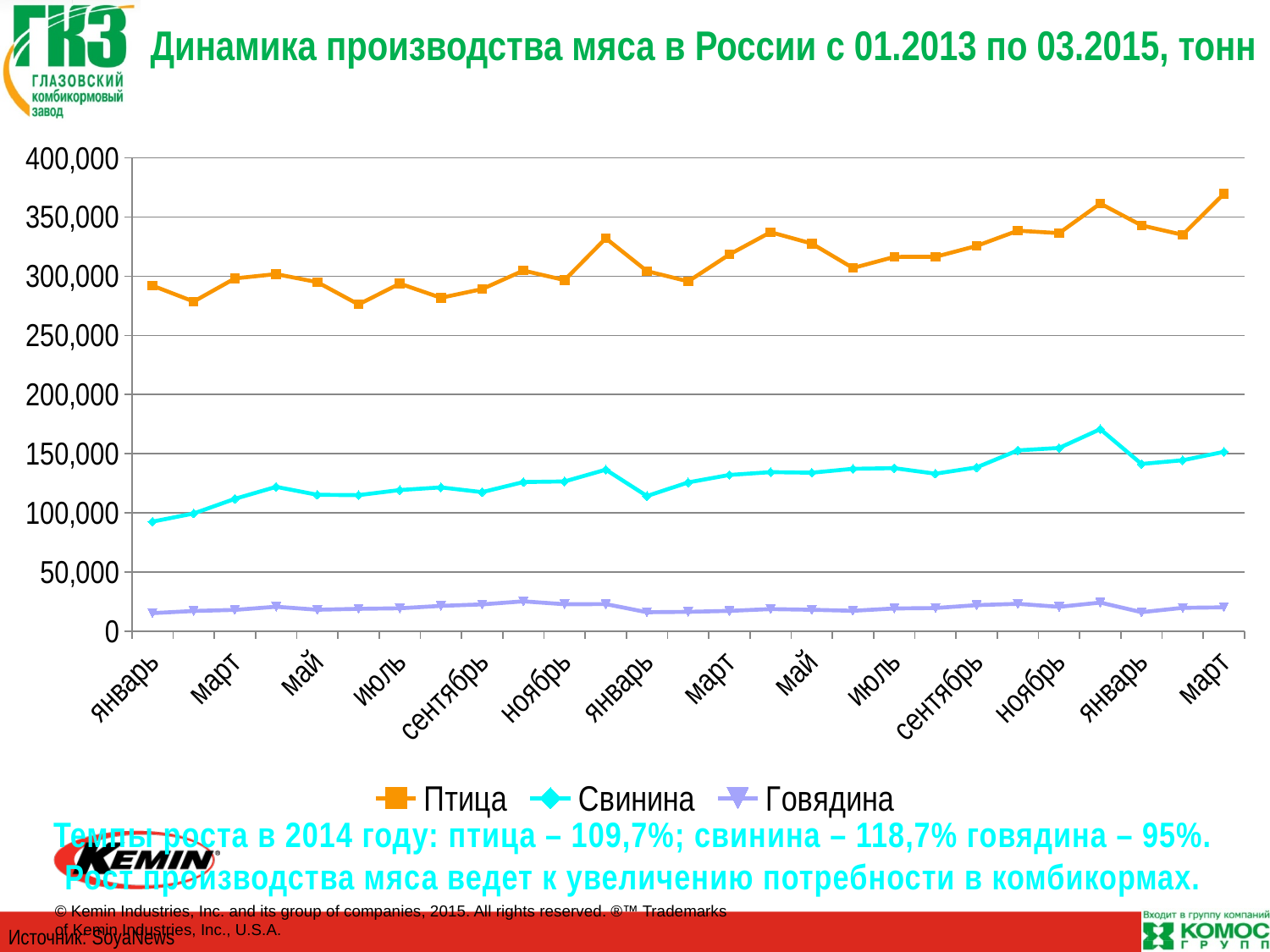
Which series has the lowest values throughout the chart? Говядина Is the value for Птица at the first январь greater or less than 250,000? greater Which series has the highest values throughout the chart? Птица Is the value for Говядина at any point greater or less than 50,000? less Is the value for Птица at the last март greater or less than 350,000? greater Which series are listed in the legend? Птица, Свинина, Говядина Does the Птица series generally rise or fall from the first январь to the last март? rise Which is larger at the last март: Свинина or Говядина? Свинина What is the title of the chart? Динамика производства мяса в России с 01.2013 по 03.2015, тонн What kind of chart is shown on the slide? line chart How many series does the legend list? 3